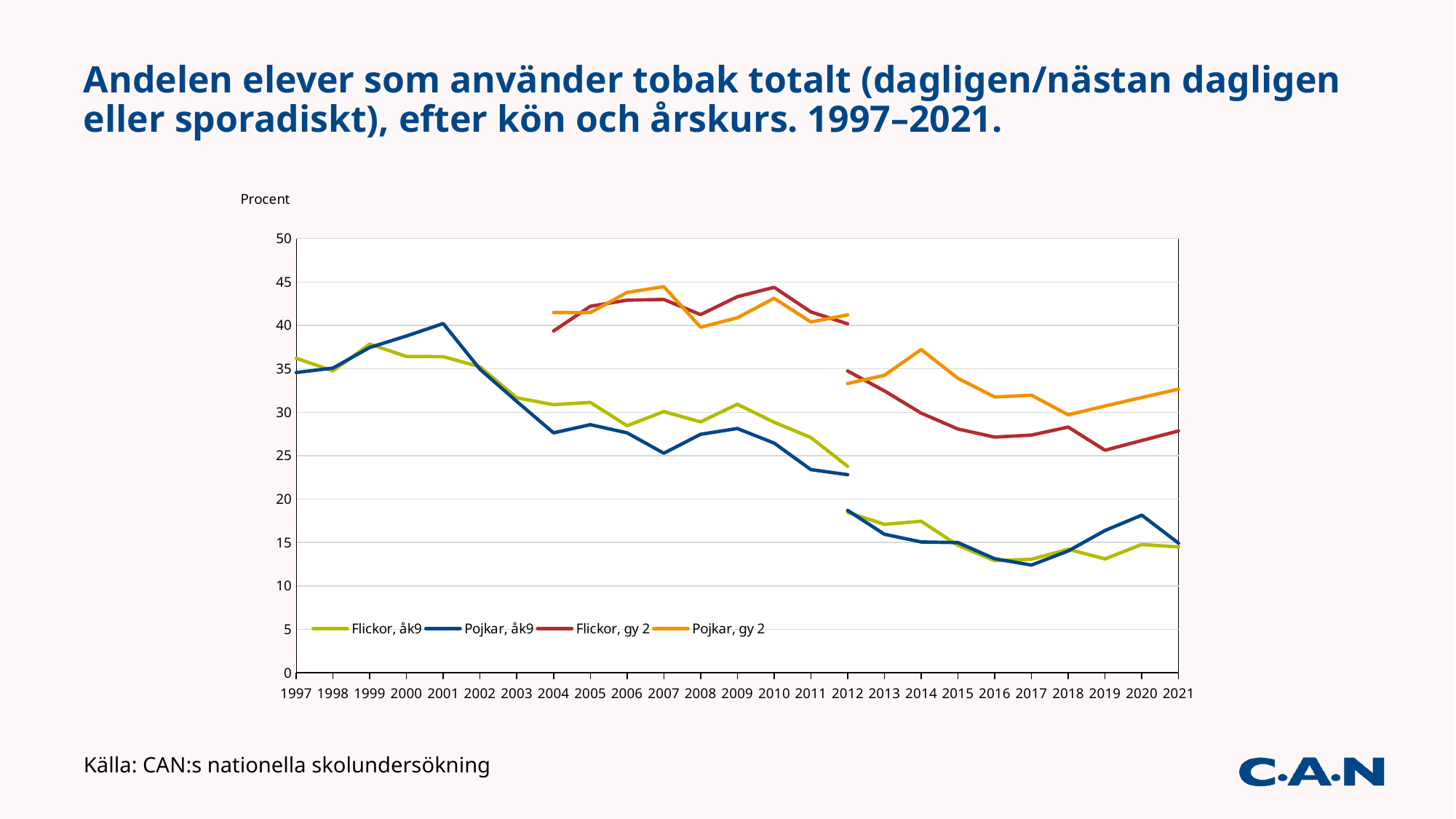
What is the label on the y axis? Procent Is the value for Pojkar, åk9 in 2001 greater or less than 35? greater Does the Pojkar, åk9 line rise or fall from 2001 to 2012? Fall What kind of chart is shown on the slide? Line chart Is the value for Pojkar, gy 2 in 2021 greater or less than 30? greater How many years are shown on the x axis? 25 In 2014, which is larger: Pojkar, gy 2 or Flickor, gy 2? Pojkar, gy 2 Which series has the highest value in 2014? Pojkar, gy 2 How many series does the legend list? 4 In 2009, which is larger: Flickor, åk9 or Pojkar, åk9? Flickor, åk9 Is the value for Flickor, gy 2 in 2010 greater or less than 40? greater